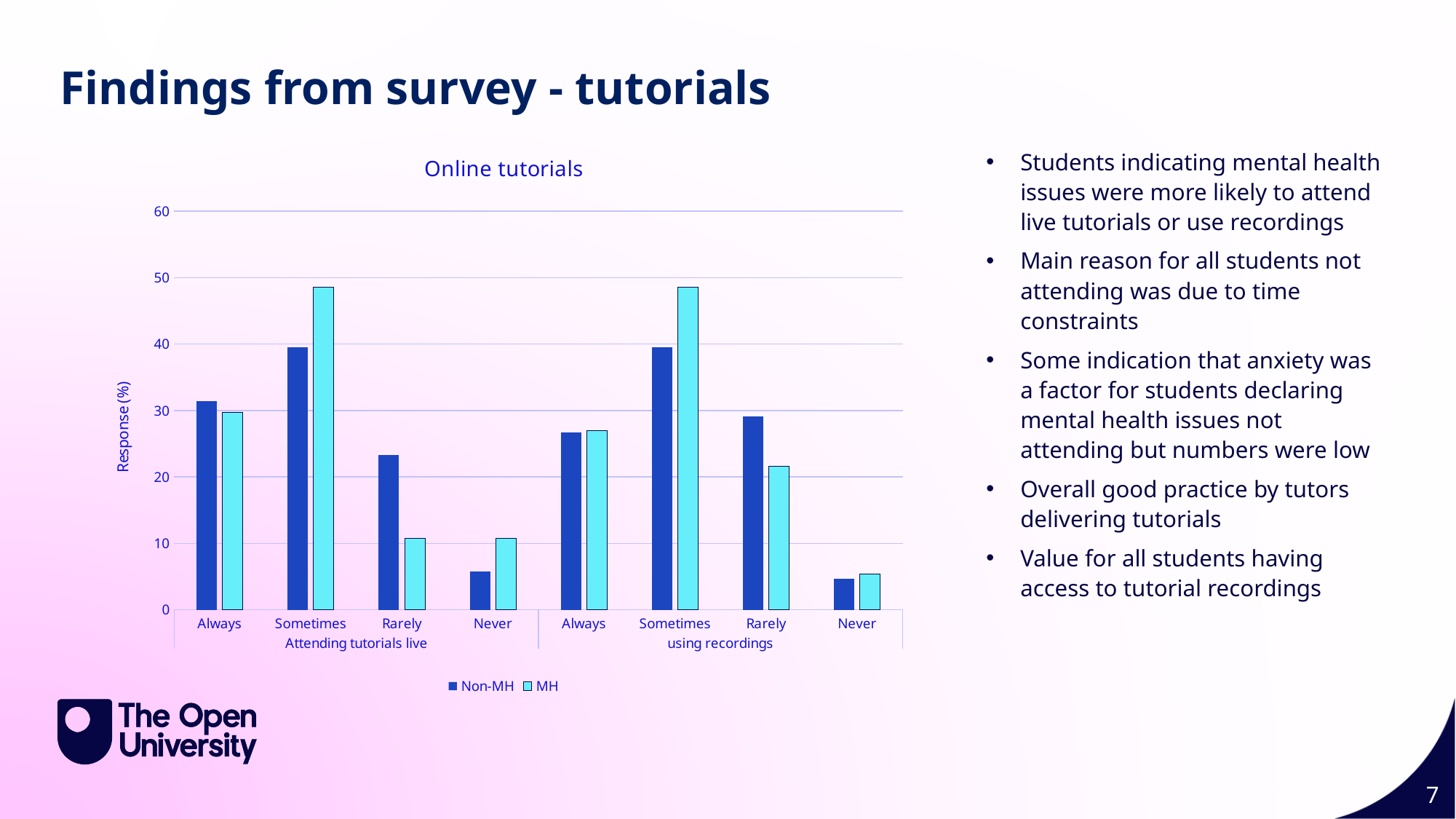
Under using recordings, which category has the lowest Non-MH value? Never How many categories are shown along the x axis of the chart? 8 For Sometimes under using recordings, which series has the larger value, Non-MH or MH? MH For Rarely under Attending tutorials live, which series has the larger value, Non-MH or MH? Non-MH Is the Non-MH value for Rarely under using recordings greater or less than 20? greater Is the Non-MH value for Never under Attending tutorials live greater or less than 10? less Is the MH value for Sometimes under Attending tutorials live greater or less than 40? greater What is the label on the vertical axis of the chart? Response (%) How many series does the legend of the chart list? 2 What is the title of the chart? Online tutorials Under Attending tutorials live, which category has the highest MH value? Sometimes What kind of chart is shown on the slide? bar chart